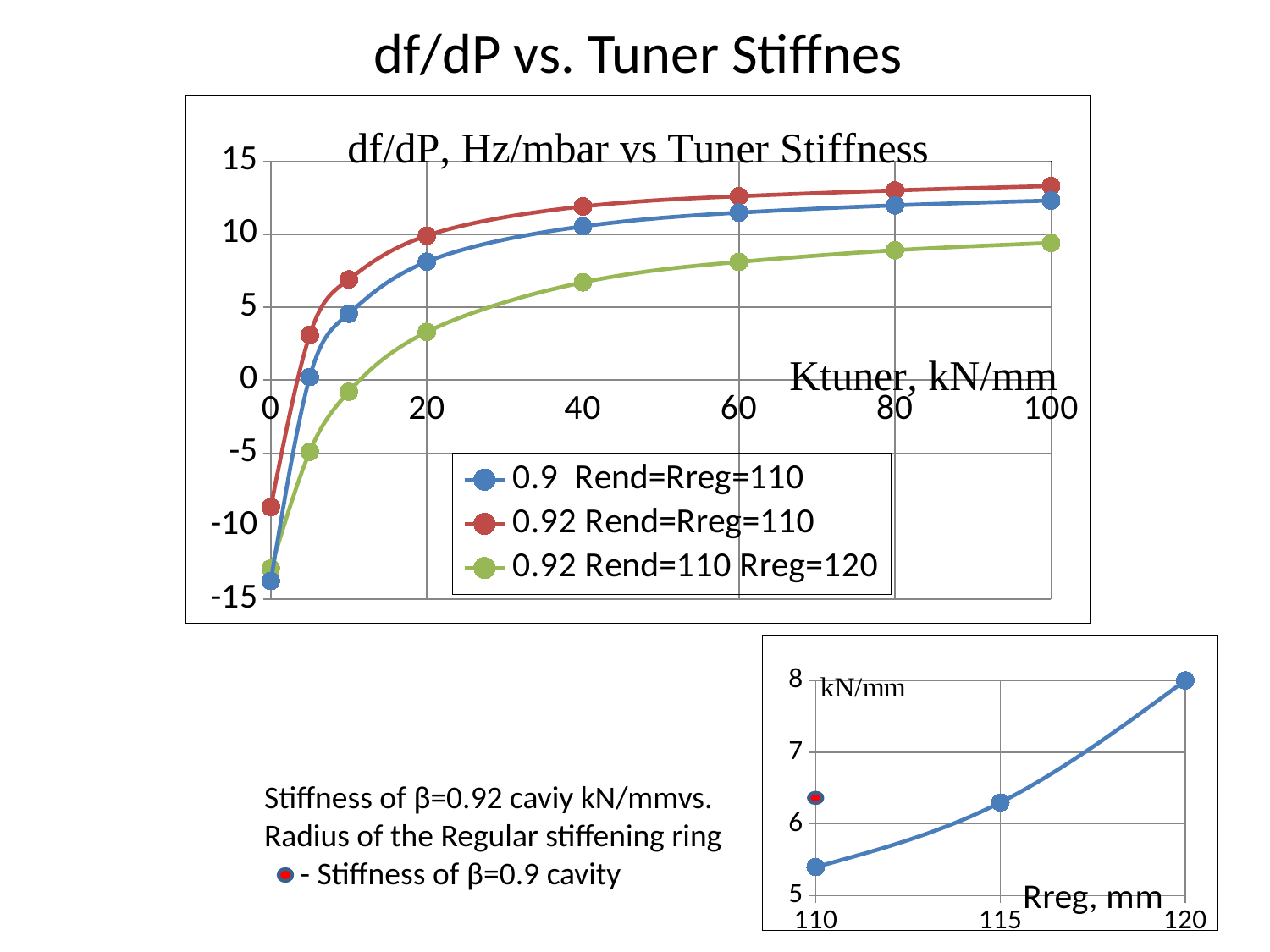
In the bottom-right chart of stiffness vs Rreg, how many data points are plotted on the blue line? 3 In the top chart 'df/dP, Hz/mbar vs Tuner Stiffness', how many series does the legend list? 3 In the top chart 'df/dP, Hz/mbar vs Tuner Stiffness', is the value of the '0.92 Rend=110 Rreg=120' series at Ktuner = 20 greater or less than 5? less In the top chart 'df/dP, Hz/mbar vs Tuner Stiffness', do the values rise or fall as Ktuner increases? rise In the top chart 'df/dP, Hz/mbar vs Tuner Stiffness', at Ktuner = 40, which series has the larger value: '0.92 Rend=Rreg=110' or '0.92 Rend=110 Rreg=120'? 0.92 Rend=Rreg=110 In the top chart 'df/dP, Hz/mbar vs Tuner Stiffness', what is the label of the x axis? Ktuner, kN/mm In the bottom-right chart of stiffness vs Rreg, is the value at Rreg = 115 greater or less than 7? less What kind of chart is the top chart titled 'df/dP, Hz/mbar vs Tuner Stiffness'? line chart In the top chart 'df/dP, Hz/mbar vs Tuner Stiffness', which series has the lowest value at Ktuner = 100? 0.92 Rend=110 Rreg=120 In the bottom-right chart of stiffness vs Rreg, what is the stiffness value at Rreg = 120 mm? 8 In the top chart 'df/dP, Hz/mbar vs Tuner Stiffness', which series has the highest value at Ktuner = 100? 0.92 Rend=Rreg=110 In the top chart 'df/dP, Hz/mbar vs Tuner Stiffness', is the value of the '0.9 Rend=Rreg=110' series at Ktuner = 20 greater or less than 5? greater